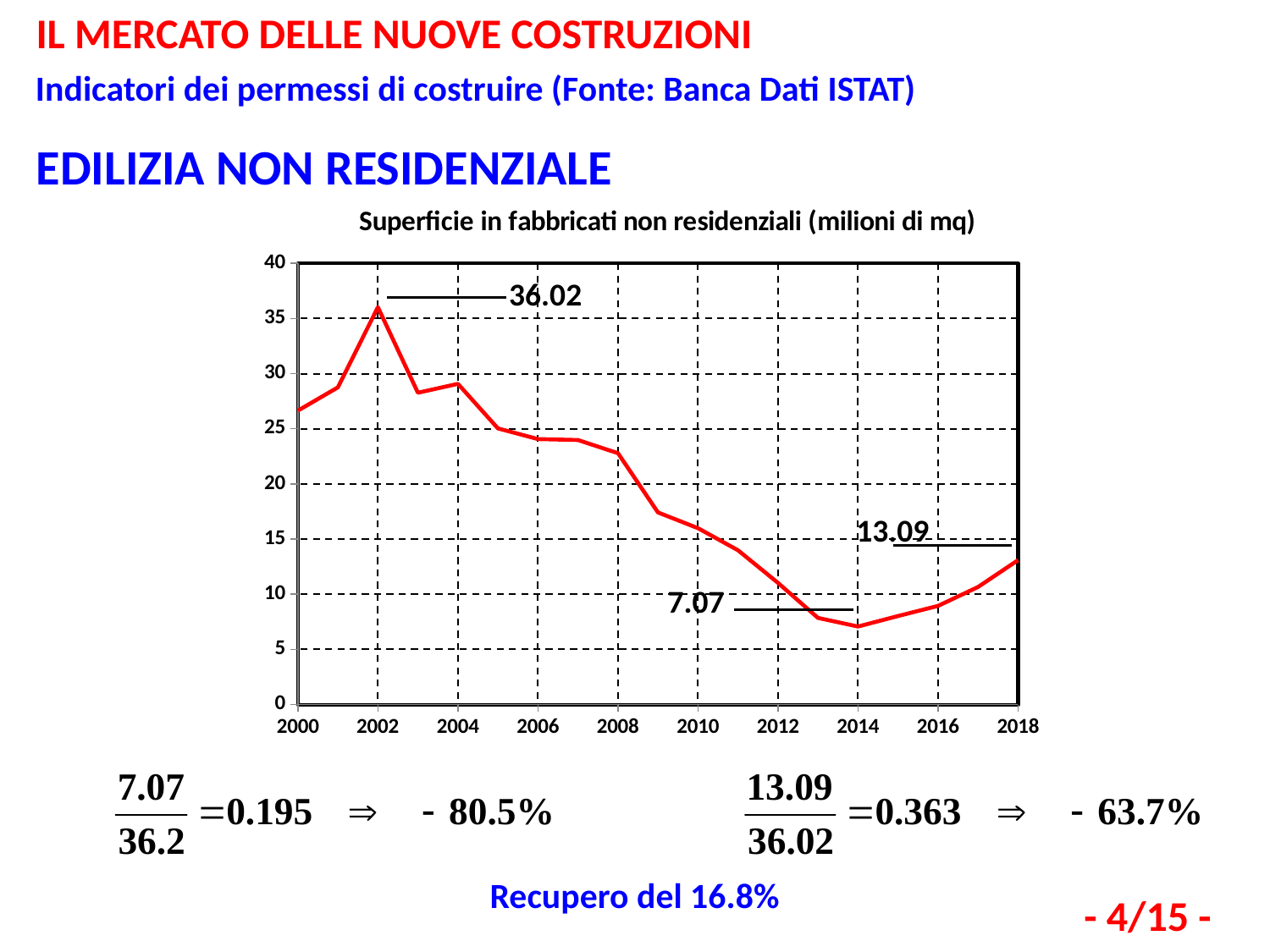
In which year does the line reach its highest value? 2002 What is the value labelled for 2018? 13.09 What is the title of the chart? Superficie in fabbricati non residenziali (milioni di mq) In which year does the line reach its lowest value? 2014 What is the difference between the 2018 value and the 2014 value? 6.02 What kind of chart is shown on the slide? line chart What is the value labelled at the lowest point of the line in 2014? 7.07 What is the value labelled at the peak of the line in 2002? 36.02 What is the difference between the 2002 peak value and the 2014 minimum value? 28.95 Does the line rise or fall between 2002 and 2014? fall Is the value for 2000 greater or less than 25? greater Is the value for 2016 greater or less than 10? less